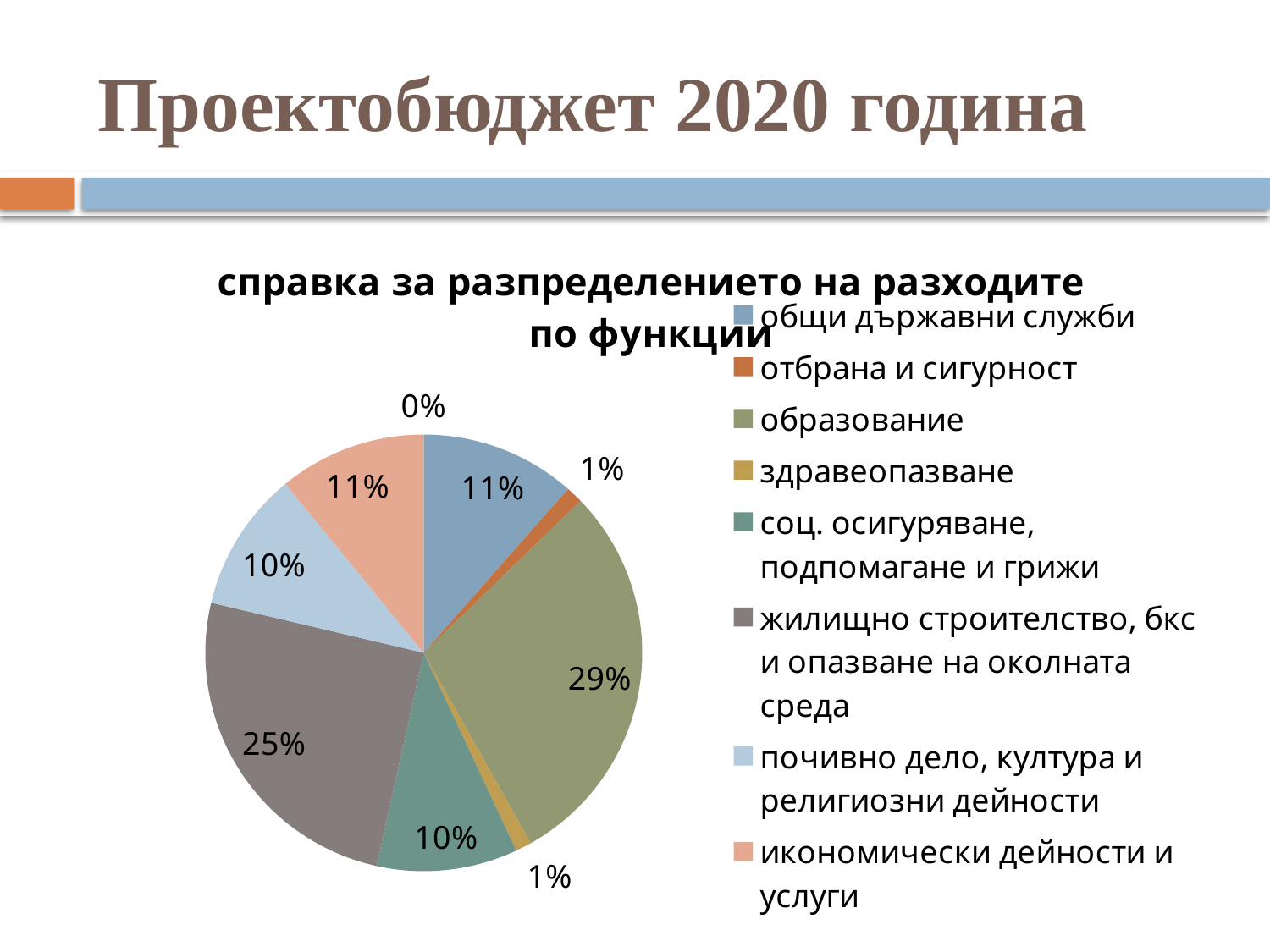
What share of the pie does жилищно строителство, бкс и опазване на околната среда have? 25% How many entries does the chart's legend list? 8 What share of the pie does образование have? 29% What share of the pie does общи държавни служби have? 11% Which category has the largest share of the pie? образование Which is larger, the share for образование or the share for жилищно строителство, бкс и опазване на околната среда? образование What kind of chart is shown on the slide? pie chart What is the title of the chart? справка за разпределението на разходите по функции What is the difference in percentage points between the share for образование and the share for почивно дело, култура и религиозни дейности? 19